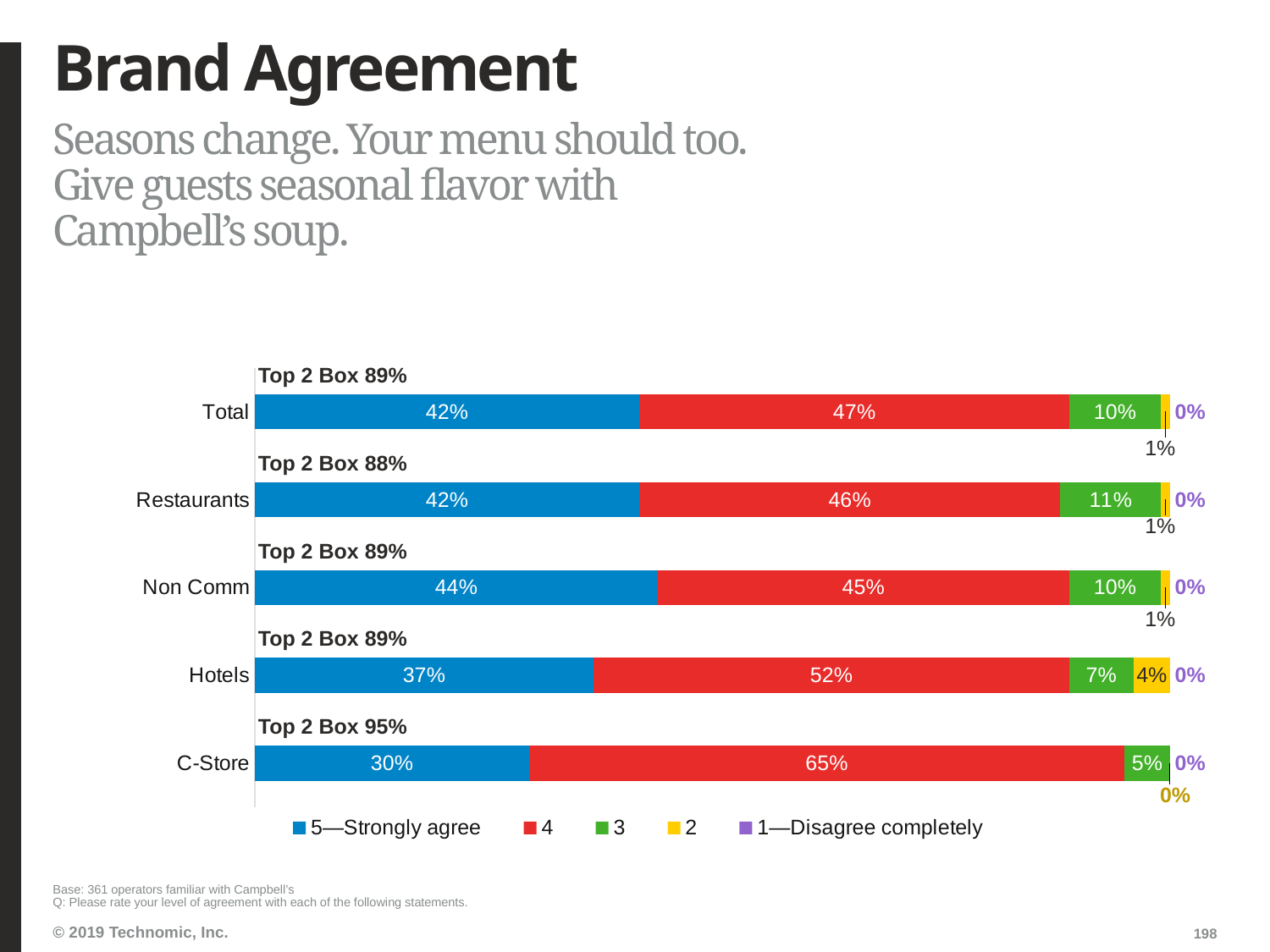
How many series does the legend list? 5 What percentage of Hotels operators selected 5—Strongly agree? 37% Which category has the highest Top 2 Box value? C-Store How many categories are shown on the chart? 5 What kind of chart is shown on the slide? Stacked bar chart Which category has the highest 5—Strongly agree percentage? Non Comm What is the difference between the rating-4 percentage for C-Store and for Total? 18% What percentage of Hotels operators gave a rating of 2? 4% What is the Top 2 Box value shown for Restaurants? 88% What percentage of C-Store operators gave a rating of 4? 65% Which is larger for Hotels: the percentage rating 5—Strongly agree or the percentage rating 4? 4 Which category has the lowest 5—Strongly agree percentage? C-Store